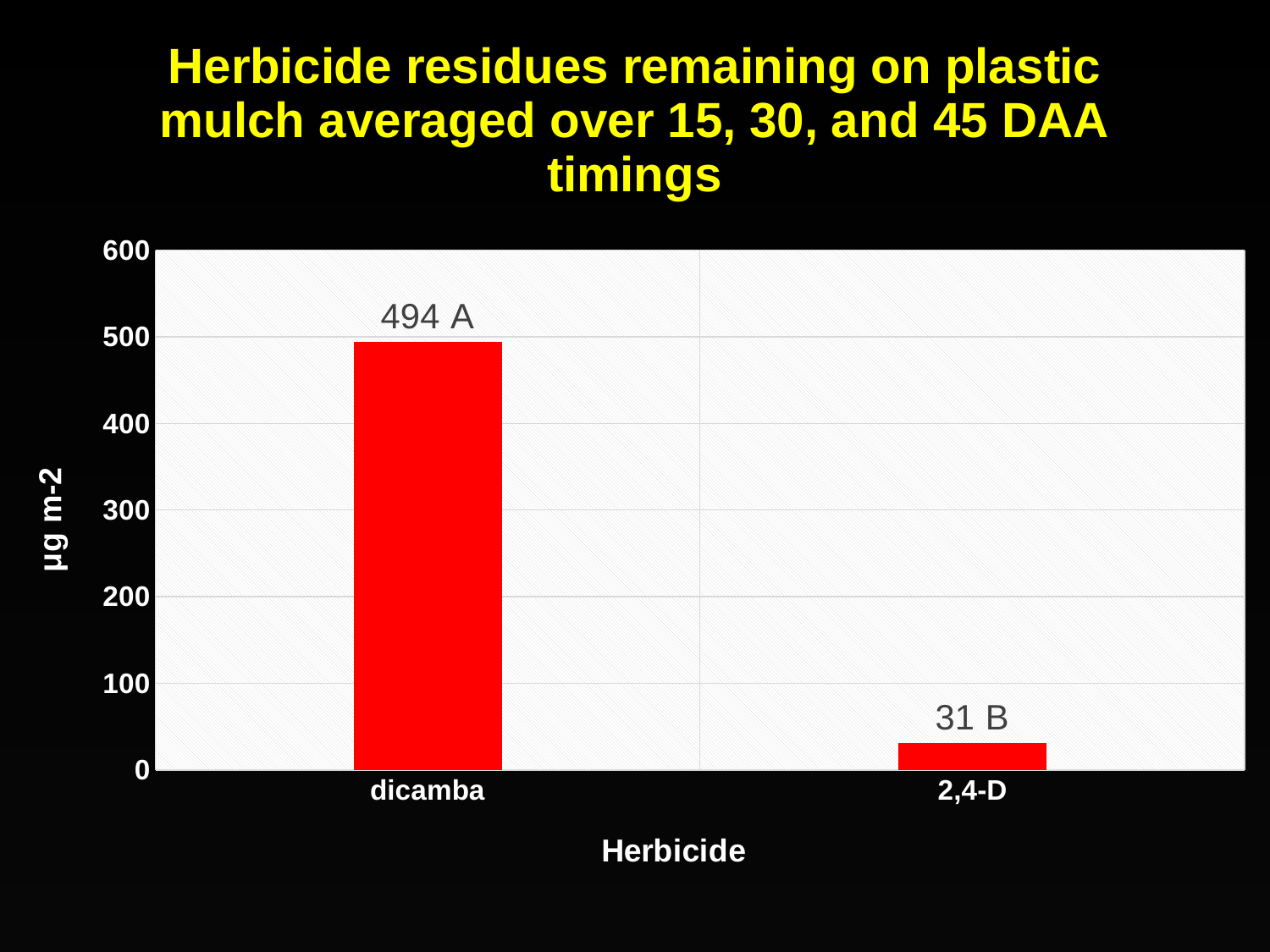
What is the label of the y axis? µg m-2 How many herbicides are shown on the x axis? 2 Which herbicide has the lowest residue value? 2,4-D Is the value for 2,4-D greater or less than 100? less What is the label of the x axis? Herbicide Which has a larger value, dicamba or 2,4-D? dicamba What kind of chart is shown on the slide? bar chart Which herbicide has the highest residue value? dicamba What is the value shown for dicamba? 494 Is the value for dicamba greater or less than 400? greater What is the difference between the values for dicamba and 2,4-D? 463 What is the value shown for 2,4-D? 31